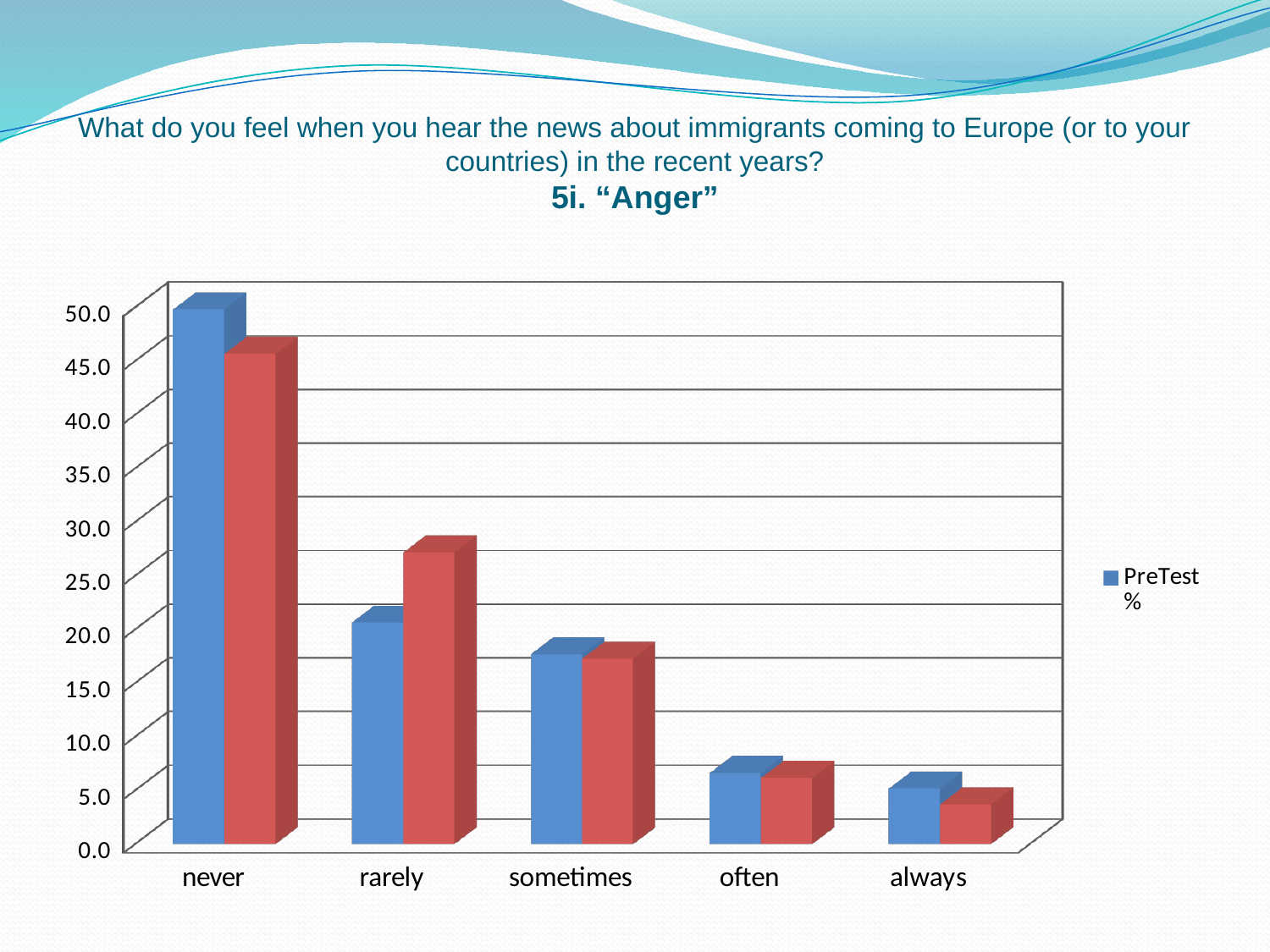
Is the blue (PreTest %) value for "never" greater or less than 45? greater Which category has the highest blue (PreTest %) bar? never Is the blue (PreTest %) value for "sometimes" greater or less than 20? less Do the blue (PreTest %) values rise or fall moving from "never" to "always" along the x axis? fall Is the red bar value for "rarely" greater or less than 25? greater What series name is shown in the chart legend? PreTest % How many categories are shown on the x axis? 5 For the "rarely" category, which bar is taller, the blue one or the red one? the red one For the "never" category, which bar is taller, the blue one or the red one? the blue one Which category has the lowest blue (PreTest %) bar? always What kind of chart is shown on the slide? bar chart